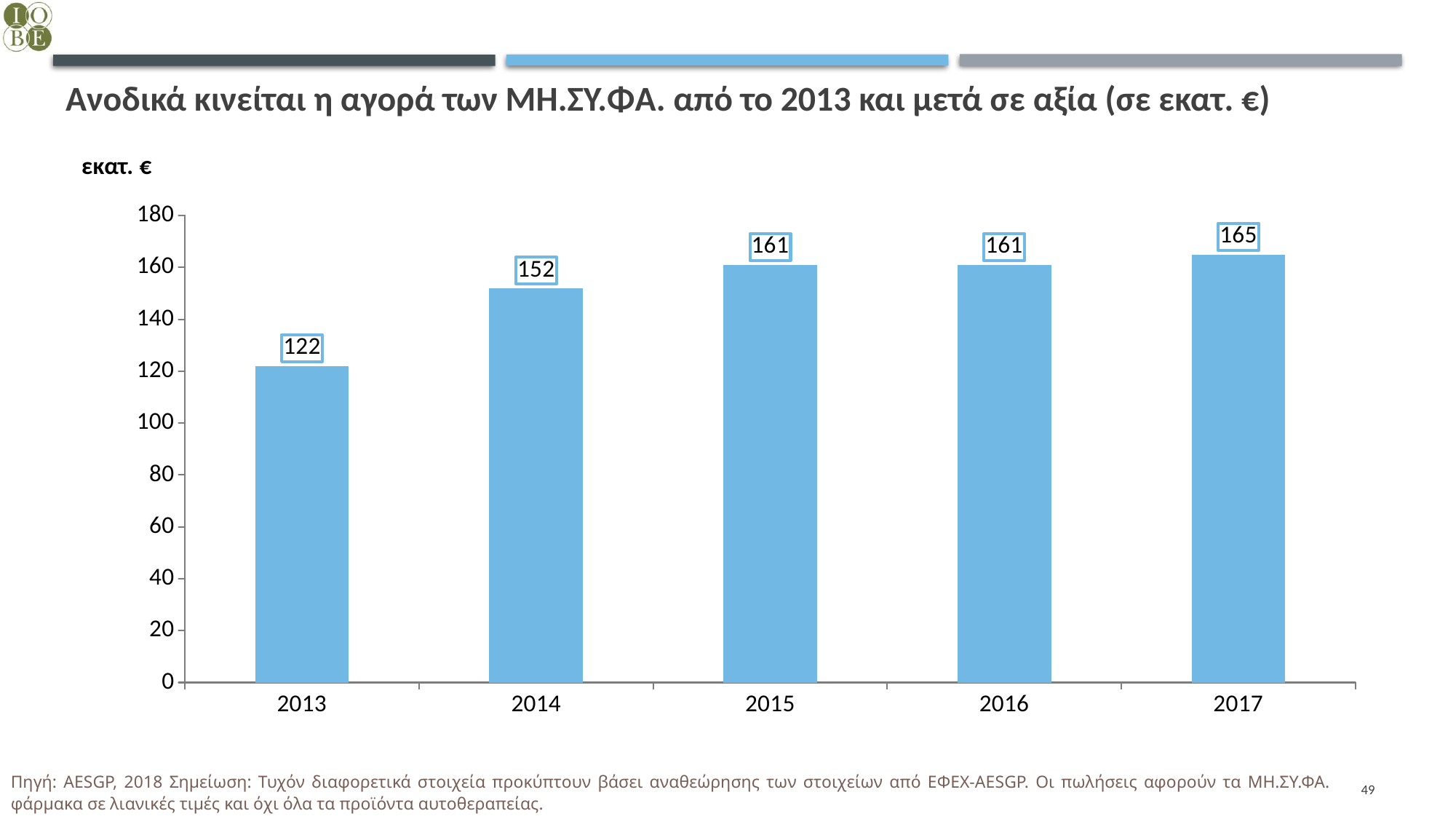
What is the value for 2013? 122 How many years are shown on the x axis? 5 Which is larger, the value for 2014 or the value for 2015? 2015 What is the value for 2017? 165 What is the difference between the values for 2017 and 2013? 43 What is the difference between the values for 2014 and 2013? 30 What kind of chart is shown on the slide? bar chart What is the value for 2014? 152 Is the value for 2013 greater or less than 140? less Which year has the lowest value? 2013 Do the values generally rise or fall from 2013 to 2017? rise Which year has the highest value? 2017